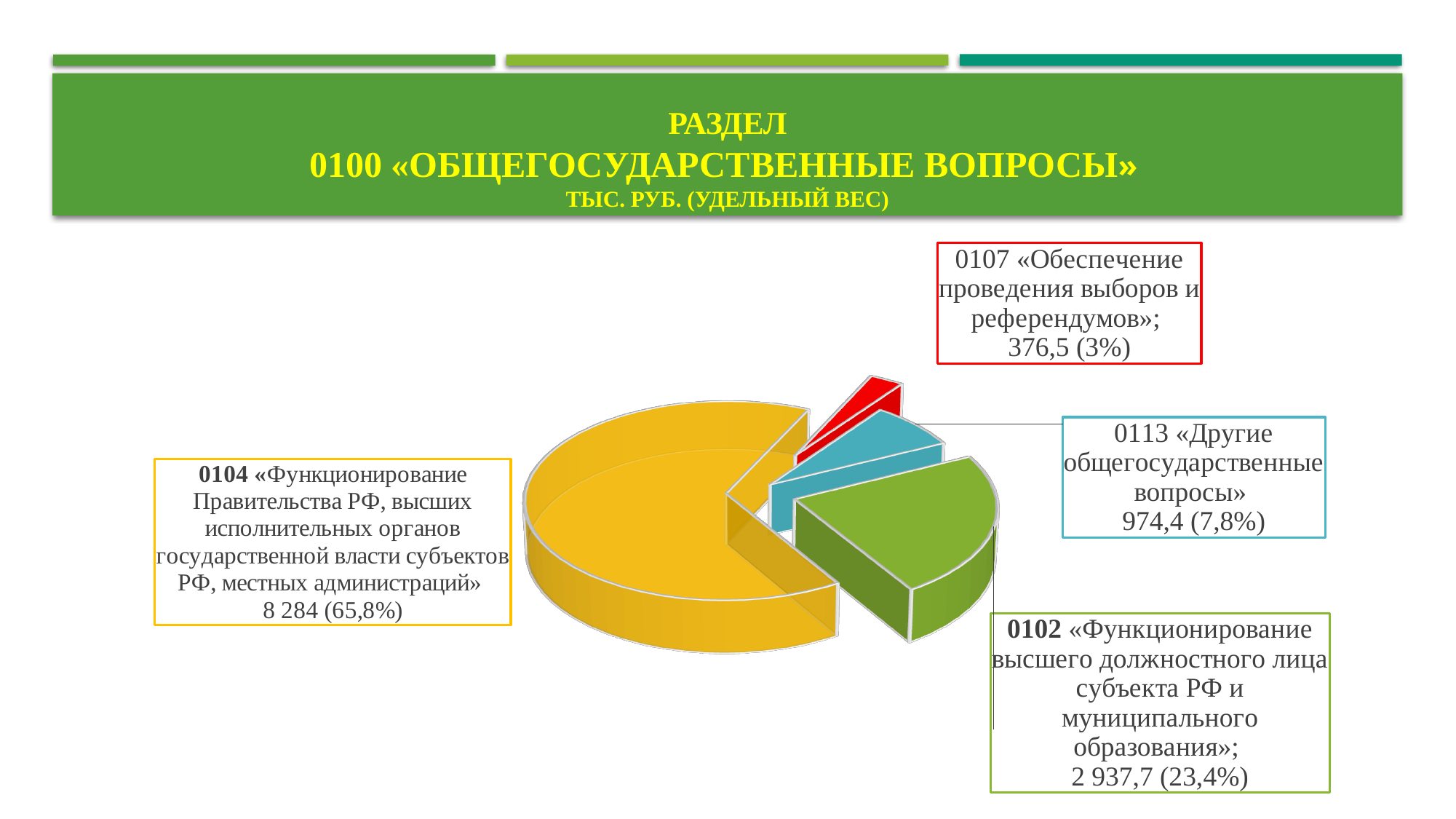
What is the value for subsection 0113 «Другие общегосударственные вопросы»? 974,4 (7,8%) What share of the pie does subsection 0102 represent? 23,4% What is the value for subsection 0107 «Обеспечение проведения выборов и референдумов»? 376,5 (3%) How many slices does the pie chart have? 4 What is the value for subsection 0104 «Функционирование Правительства РФ...»? 8 284 (65,8%) What kind of chart is shown on the slide? Pie chart Which is larger, the value for subsection 0113 or for subsection 0107? 0113 What is the value for subsection 0102 «Функционирование высшего должностного лица...»? 2 937,7 (23,4%) What colour is the slice for subsection 0107 «Обеспечение проведения выборов и референдумов»? Red Which subsection has the smallest share of the pie? 0107 Which subsection has the largest share of the pie? 0104 What is the difference between the values for subsection 0104 and subsection 0102 (in thousand rubles)? 5 346,3